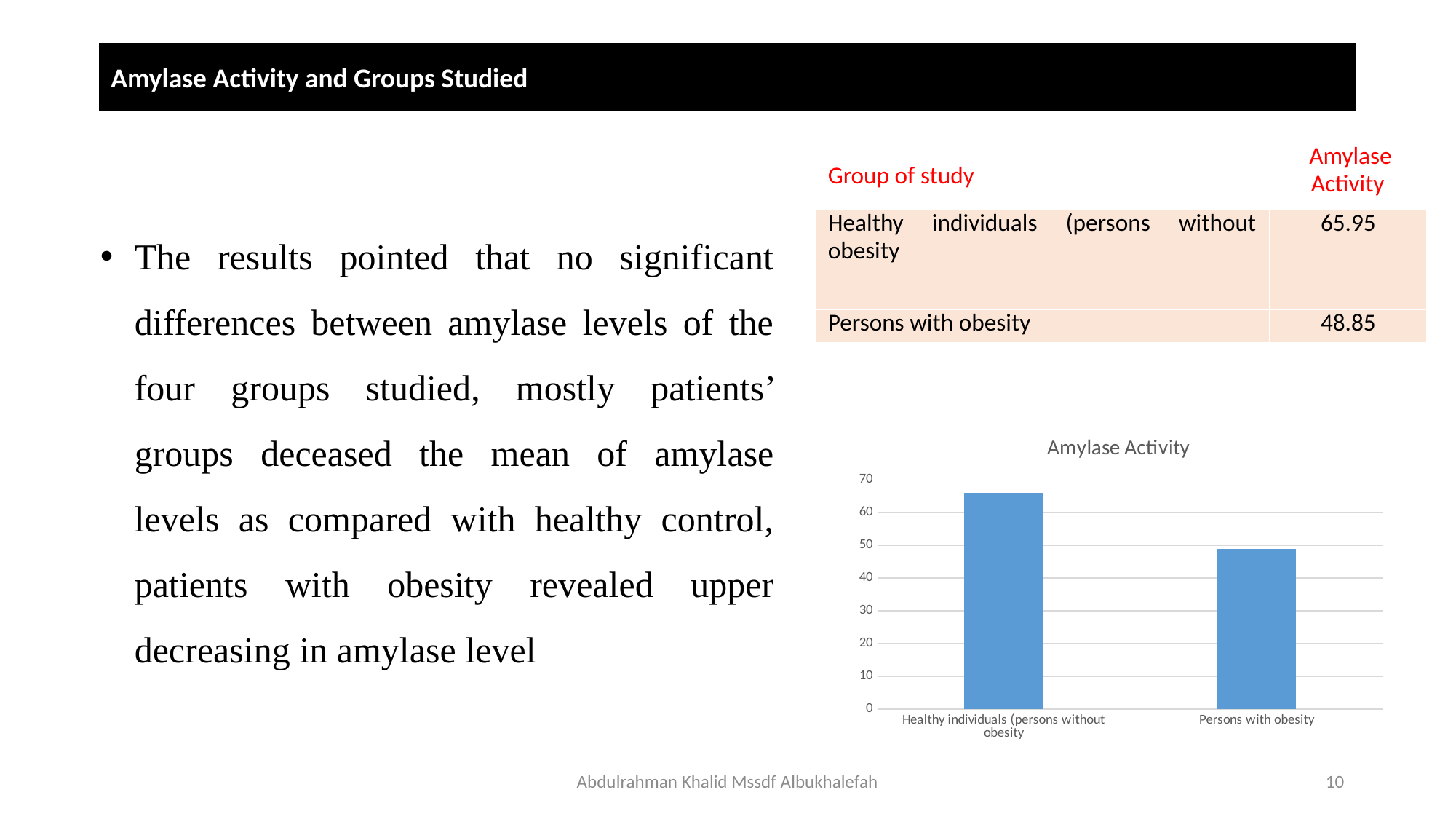
What type of chart is shown on the slide? bar chart What is the difference in amylase activity between Healthy individuals (persons without obesity and Persons with obesity? 17.10 What is the amylase activity value for Healthy individuals (persons without obesity, as printed on the slide? 65.95 What is the amylase activity value for Persons with obesity, as printed on the slide? 48.85 Which category has the highest amylase activity in the chart? Healthy individuals (persons without obesity Is the amylase activity for Healthy individuals (persons without obesity greater or less than 60? greater What is the title of the chart? Amylase Activity How many categories are plotted in the chart? 2 What is the highest value shown on the chart's vertical axis? 70 Is the amylase activity for Persons with obesity greater or less than 50? less Which category has the lowest amylase activity in the chart? Persons with obesity Which is larger, the amylase activity for Healthy individuals (persons without obesity or for Persons with obesity? Healthy individuals (persons without obesity